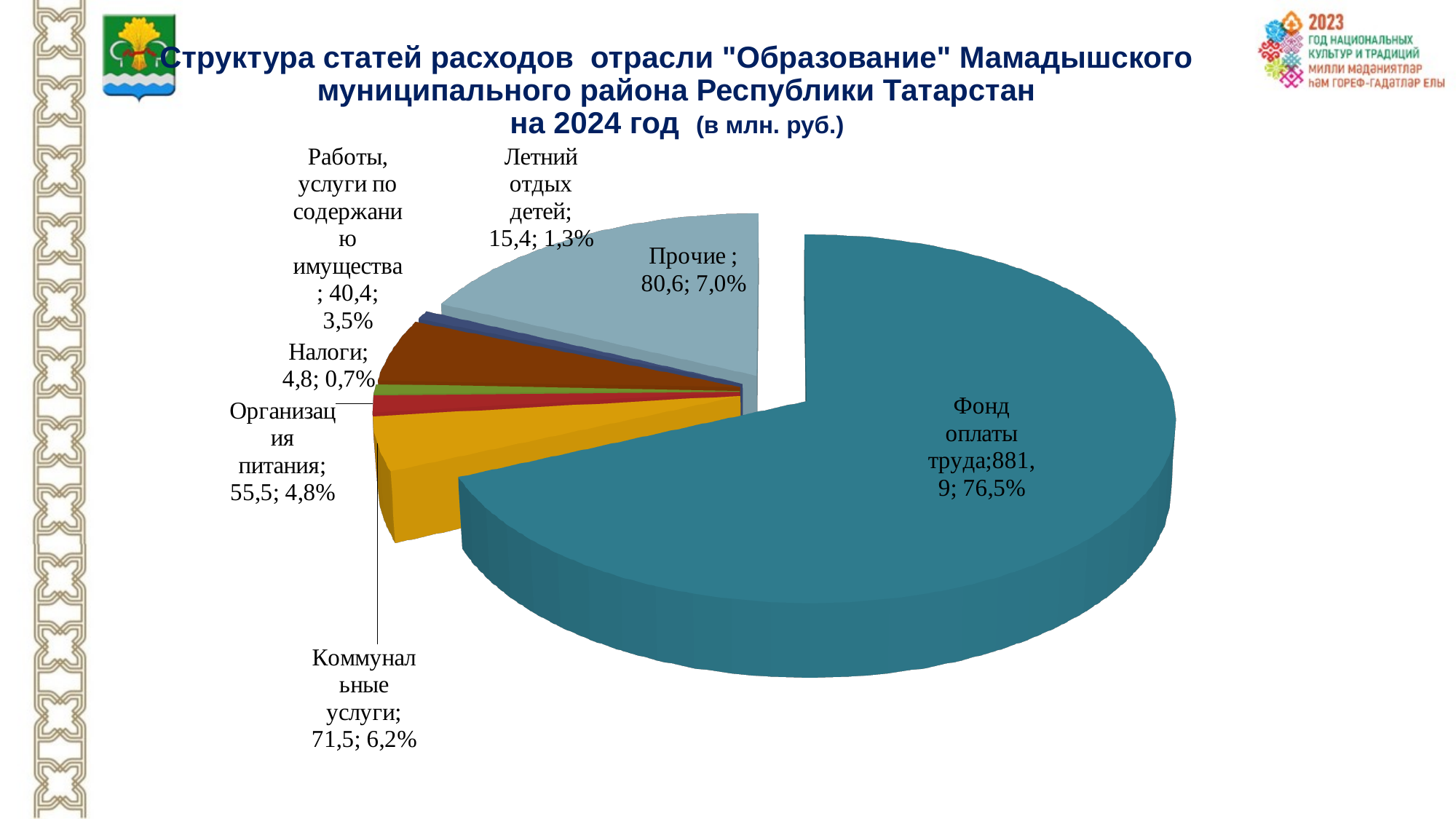
Which category has the largest slice in the pie chart? Фонд оплаты труда What kind of chart is shown on the slide? pie chart What is the value for "Фонд оплаты труда" in the pie chart? 881,9 In what units are the values in the chart expressed, according to the title? млн. руб. What is the value for "Коммунальные услуги"? 71,5 Which is larger: the value for "Организация питания" or the value for "Работы, услуги по содержанию имущества"? Организация питания What percentage share is shown for "Прочие"? 7,0% How many categories (slices) does the pie chart show? 7 What is the value for "Летний отдых детей"? 15,4 What share of the pie does "Фонд оплаты труда" represent? 76,5% What is the difference between the values for "Прочие" and "Коммунальные услуги"? 9,1 Which category has the smallest slice in the pie chart? Налоги